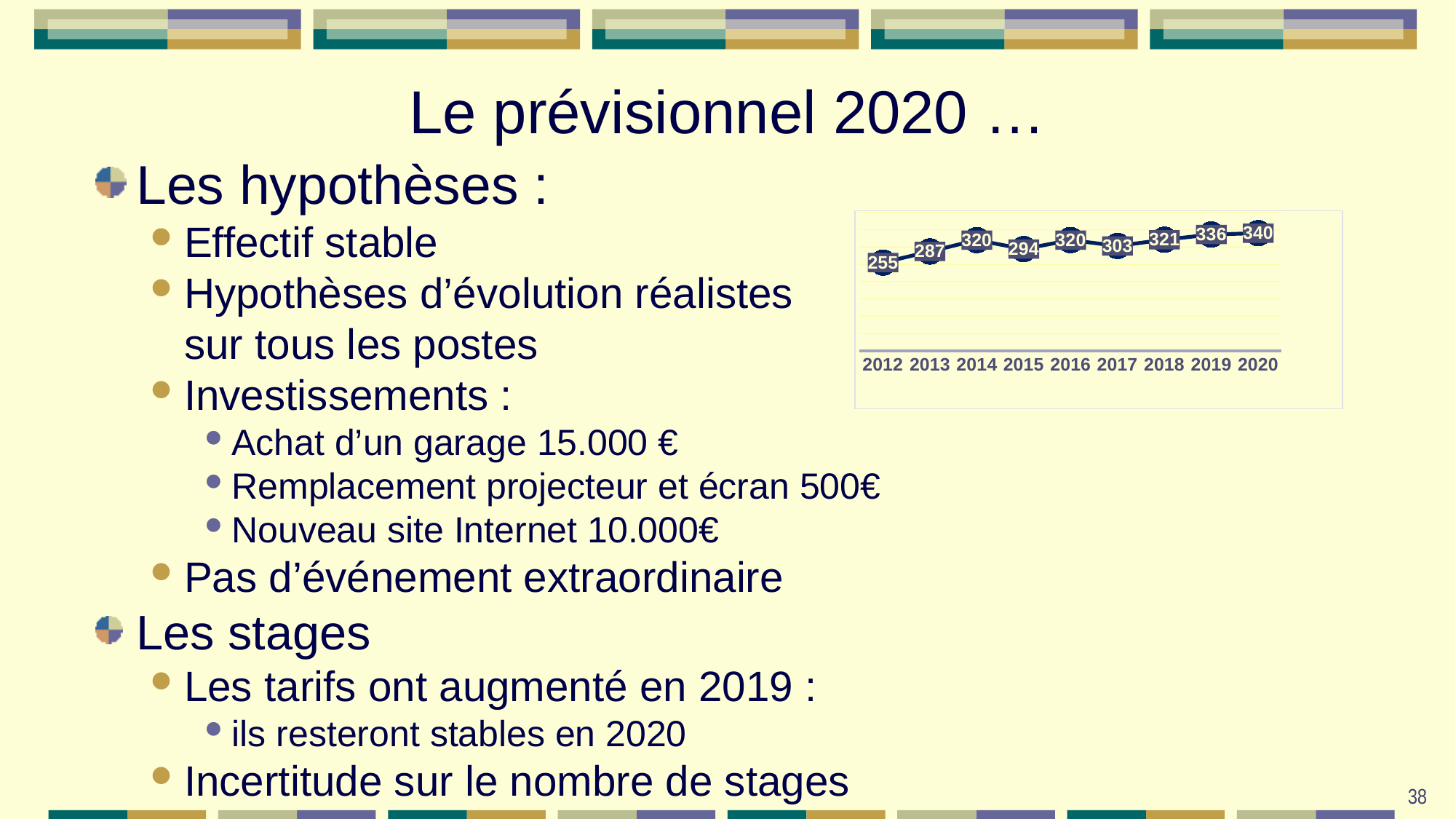
Which two years in the chart share the same value of 320? 2014 and 2016 What is the difference between the values for 2014 and 2015 in the chart? 26 Do the values in the chart generally rise or fall from 2012 to 2020? rise Which is larger in the chart, the value for 2019 or the value for 2017? 2019 Which year has the highest value in the chart? 2020 How many years are plotted in the chart? 9 What is the value plotted for 2020 in the chart? 340 What is the value plotted for 2017 in the chart? 303 What kind of chart is shown on the slide? line chart What is the difference between the values for 2020 and 2012 in the chart? 85 Which year has the lowest value in the chart? 2012 What is the value plotted for 2012 in the chart? 255